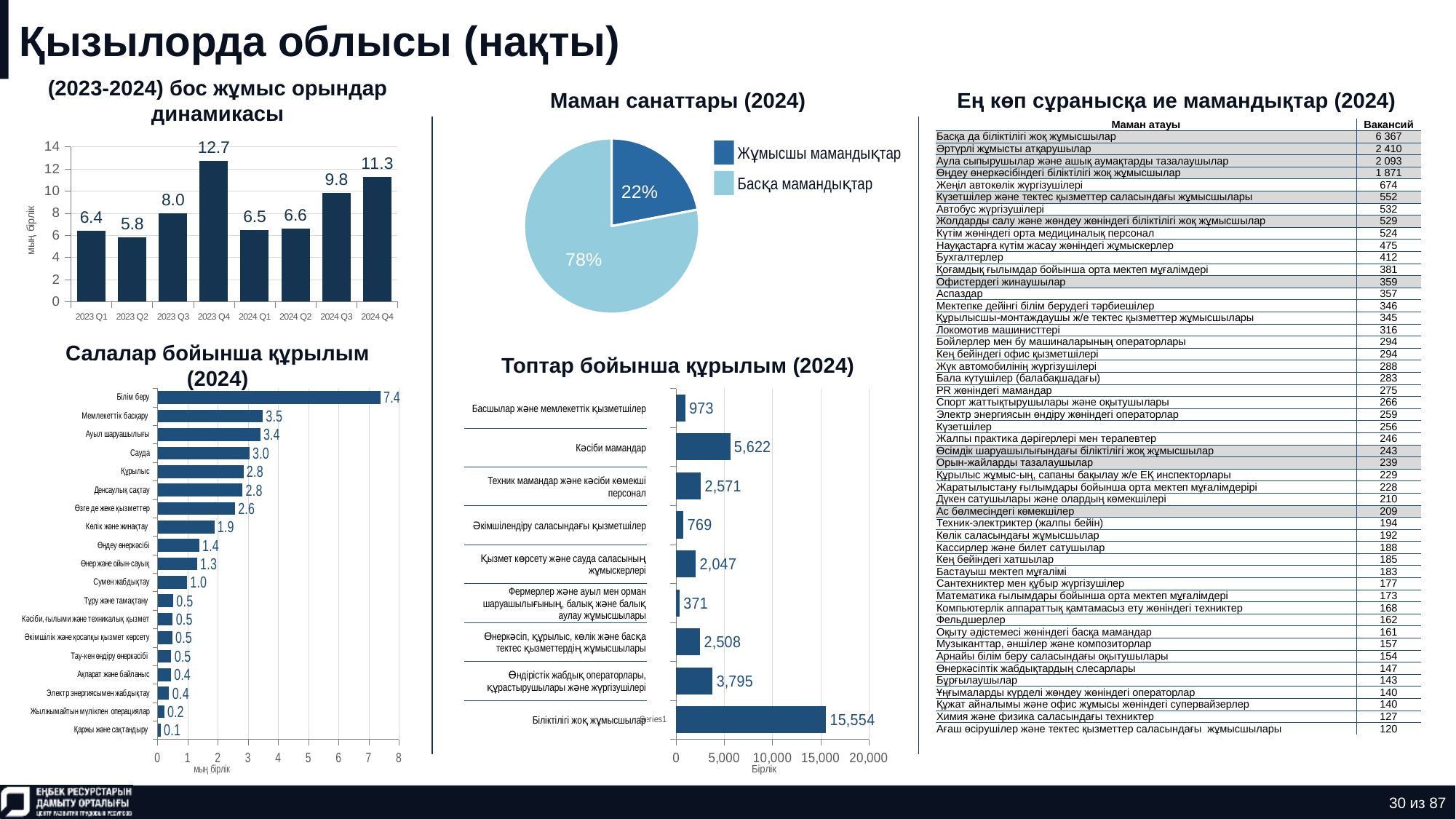
What kind of chart is 'Топтар бойынша құрылым (2024)'? Bar chart In the chart 'Салалар бойынша құрылым (2024)', which is larger: 'Мемлекеттік басқару' or 'Сауда'? Мемлекеттік басқару In the chart '(2023-2024) бос жұмыс орындар динамикасы', how many quarters are plotted? 8 In the chart '(2023-2024) бос жұмыс орындар динамикасы', which quarter has the lowest value? 2023 Q2 In the chart 'Салалар бойынша құрылым (2024)', what is the value for 'Білім беру'? 7.4 In the pie chart 'Маман санаттары (2024)', what share does 'Жұмысшы мамандықтар' have? 22% In the chart 'Салалар бойынша құрылым (2024)', which category has the lowest value? Қаржы және сақтандыру How many entries does the legend of the pie chart 'Маман санаттары (2024)' list? 2 In the chart '(2023-2024) бос жұмыс орындар динамикасы', what is the value for 2023 Q4? 12.7 In the chart 'Топтар бойынша құрылым (2024)', which category has the highest value? Біліктілігі жоқ жұмысшылар In the chart '(2023-2024) бос жұмыс орындар динамикасы', what is the difference between 2024 Q4 and 2024 Q3? 1.5 In the chart 'Топтар бойынша құрылым (2024)', what is the value for 'Кәсіби мамандар'? 5,622